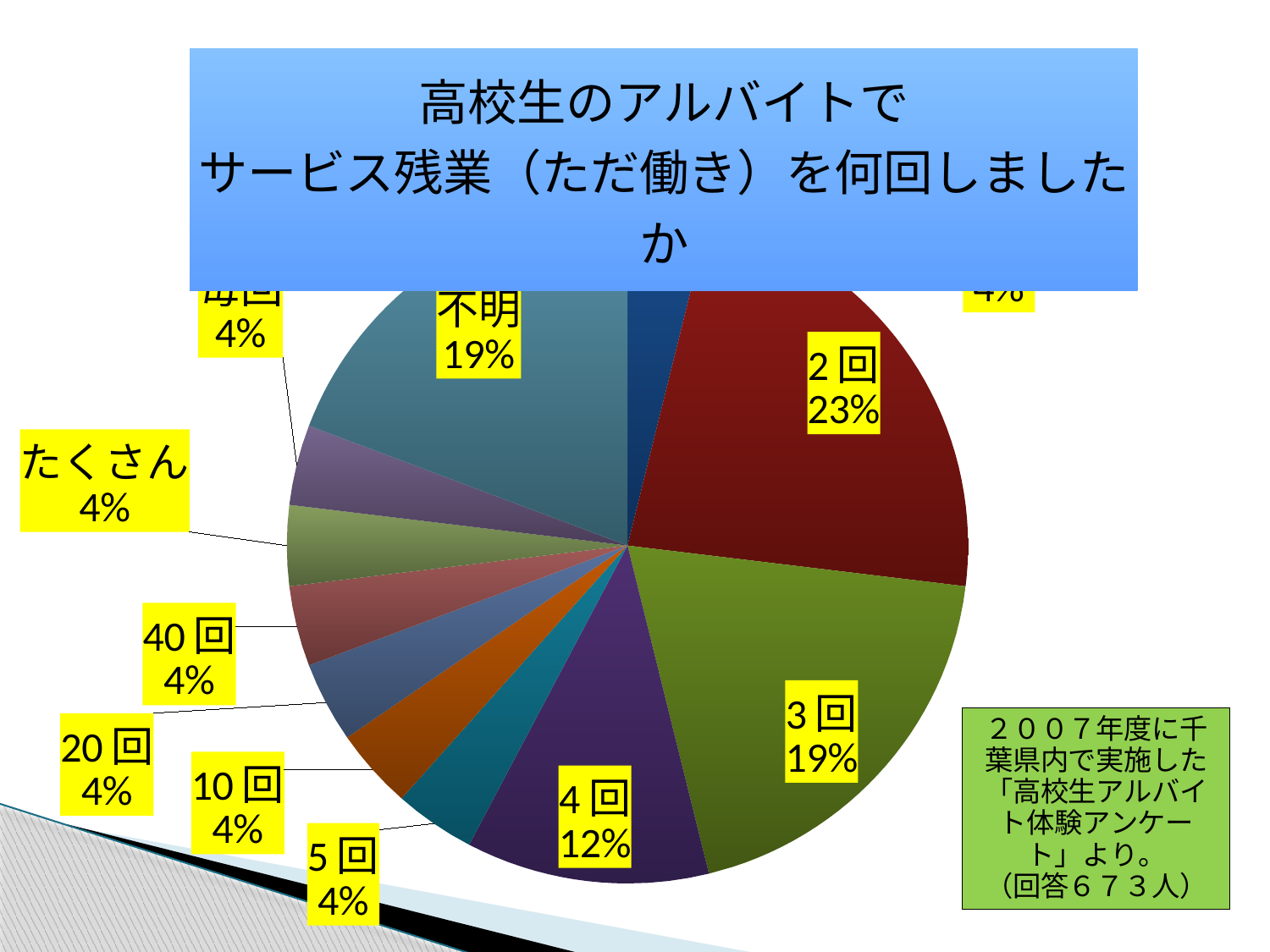
What percentage is shown for 不明? 19% What percentage is shown for たくさん? 4% What is the title of the chart? 高校生のアルバイトでサービス残業（ただ働き）を何回しましたか Which labelled category has the largest share of the pie? 2回 What share of the pie does 4回 represent? 12% What percentage of respondents answered 2回? 23% What percentage is shown for 4回? 12% What kind of chart is shown on the slide? pie chart Which is larger, the share for 2回 or the share for 4回? 2回 What is the difference in percentage points between 2回 and 3回? 4 What percentage is shown for 3回? 19% What percentage is shown for 10回? 4%